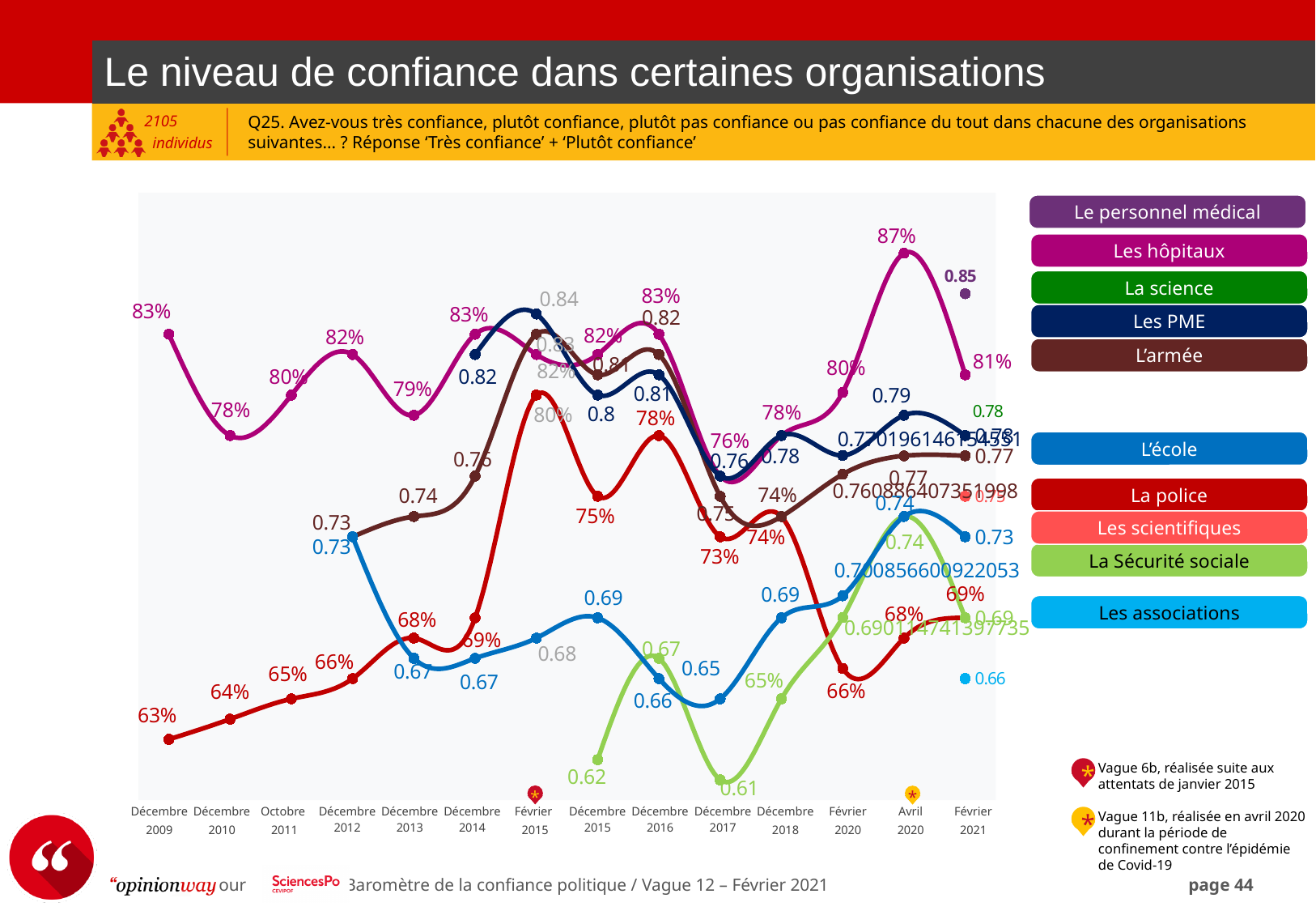
What is the difference between the Les hôpitaux values in Avril 2020 and Février 2021? 6 percentage points How many time periods are shown on the x axis? 14 What is the value for La Sécurité sociale in Décembre 2017? 0.61 What is the value for Les hôpitaux in Avril 2020? 87% What kind of chart is shown on the slide? line chart Does the value for La police rise or fall from Décembre 2009 to Décembre 2014? rise In which period does La police have its lowest value? Décembre 2009 What is the value for La police in Décembre 2009? 63% In which period does Les hôpitaux reach its highest value? Avril 2020 In Décembre 2009, which is higher: Les hôpitaux or La police? Les hôpitaux What is the value for Le personnel médical in Février 2021? 0.85 How many series does the legend list? 10